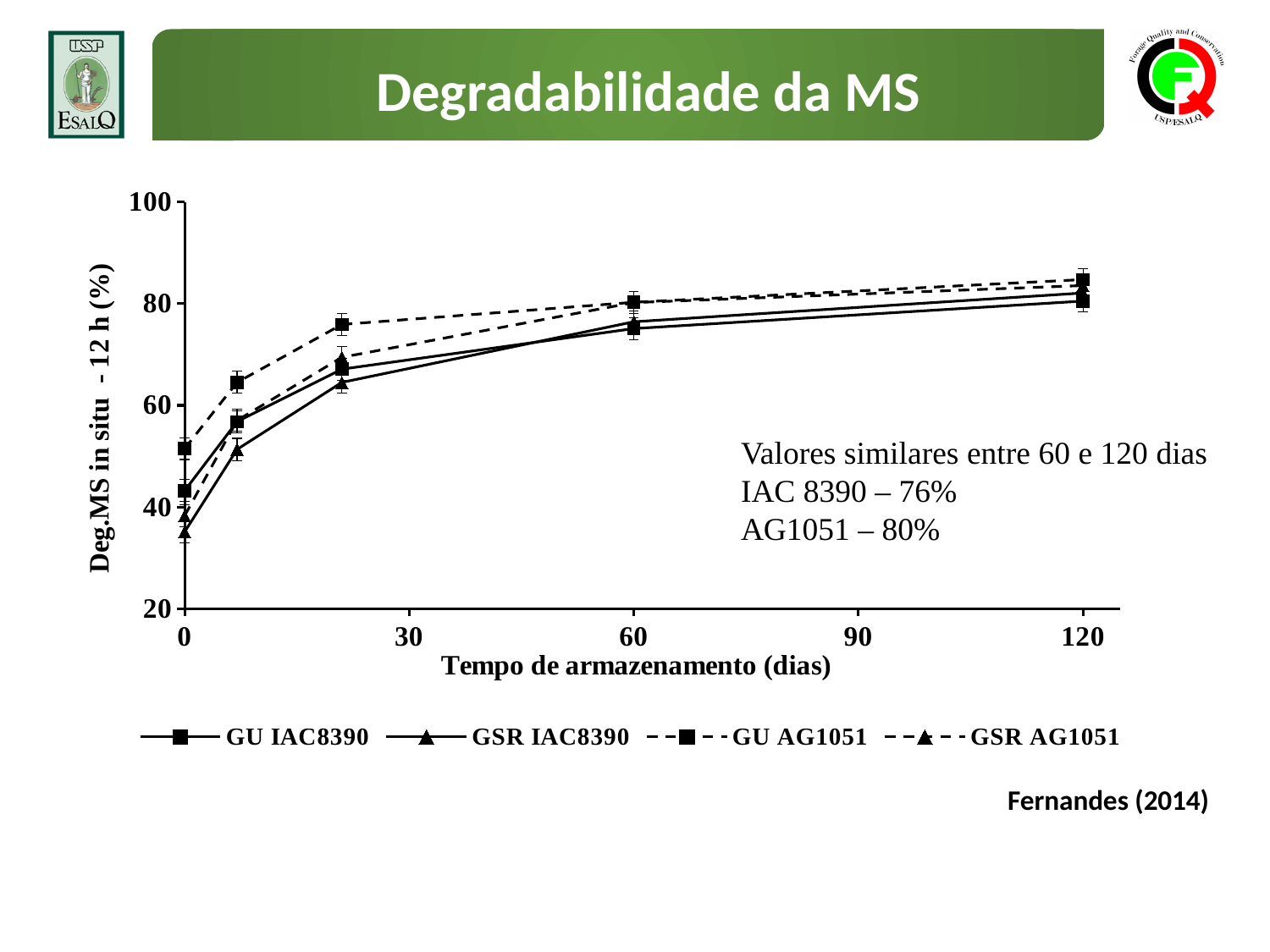
At 0 days, which is larger: GU AG1051 or GSR IAC8390? GU AG1051 Is the value for GU AG1051 at 0 days greater or less than 40? greater What is the label of the x axis? Tempo de armazenamento (dias) According to the annotation on the slide, what similar value is given for AG1051 between 60 and 120 days? 80% Is the value for GSR IAC8390 at 0 days greater or less than 40? less How many series does the legend list? 4 How many tick labels are shown on the x axis? 5 Do the values for GU IAC8390 rise or fall as storage time increases? rise Which series has the lowest value at 0 days? GSR IAC8390 Is the value for GU AG1051 at 120 days greater or less than 60? greater What is the title of the slide chart? Degradabilidade da MS What kind of chart is shown on the slide? line chart